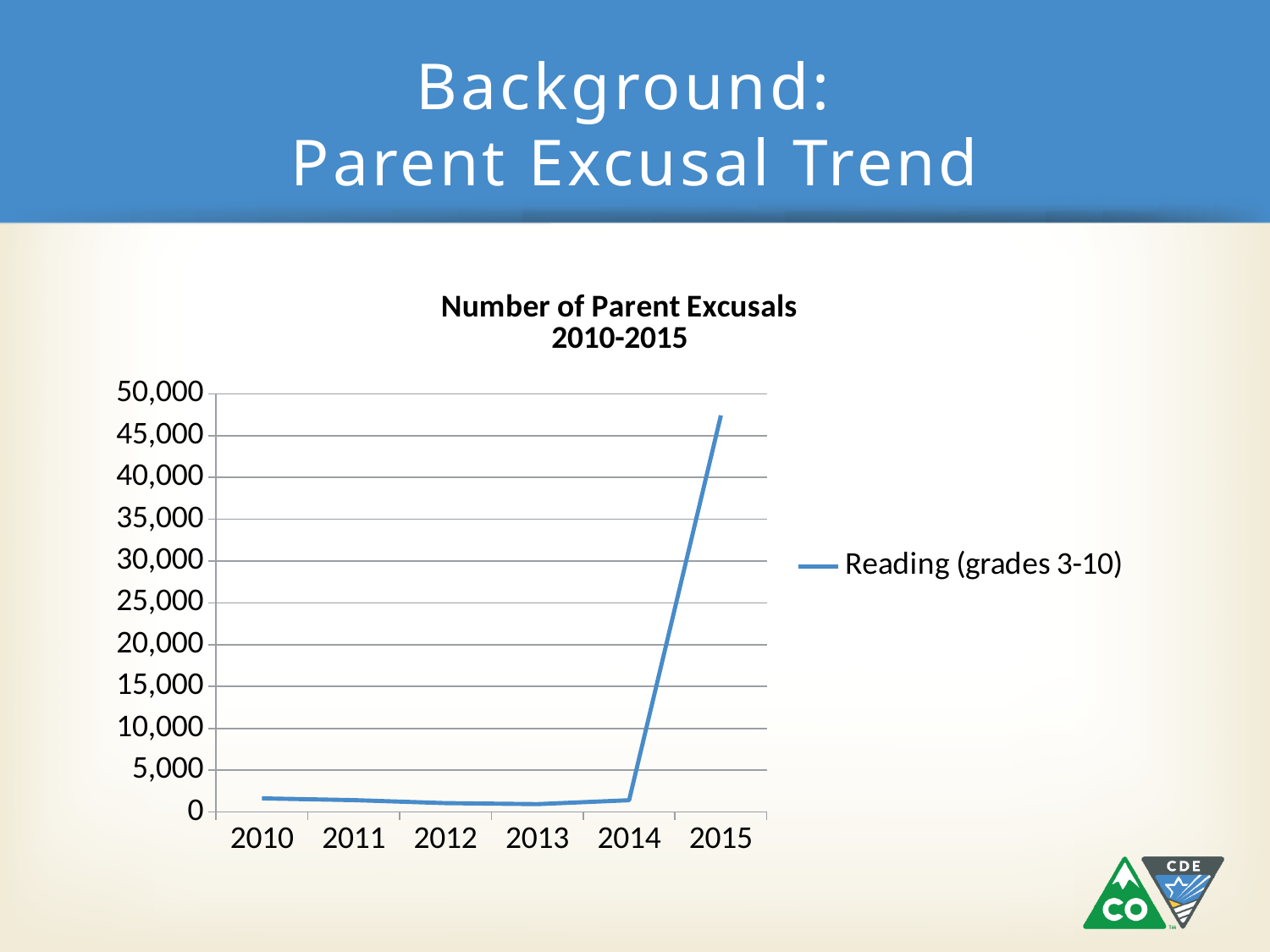
How many series does the legend list? 1 Is the value for 2010 greater or less than 5,000? less Is the value for 2014 greater or less than 5,000? less What kind of chart is shown on the slide? line chart Does the number of parent excusals rise or fall between 2014 and 2015? rise Which is larger, the value for 2015 or the value for 2014? 2015 Is the value for 2015 greater or less than 45,000? greater What series name appears in the legend? Reading (grades 3-10) Which year has the highest number of parent excusals? 2015 How many years are shown on the x axis? 6 What is the title of the chart? Number of Parent Excusals 2010-2015